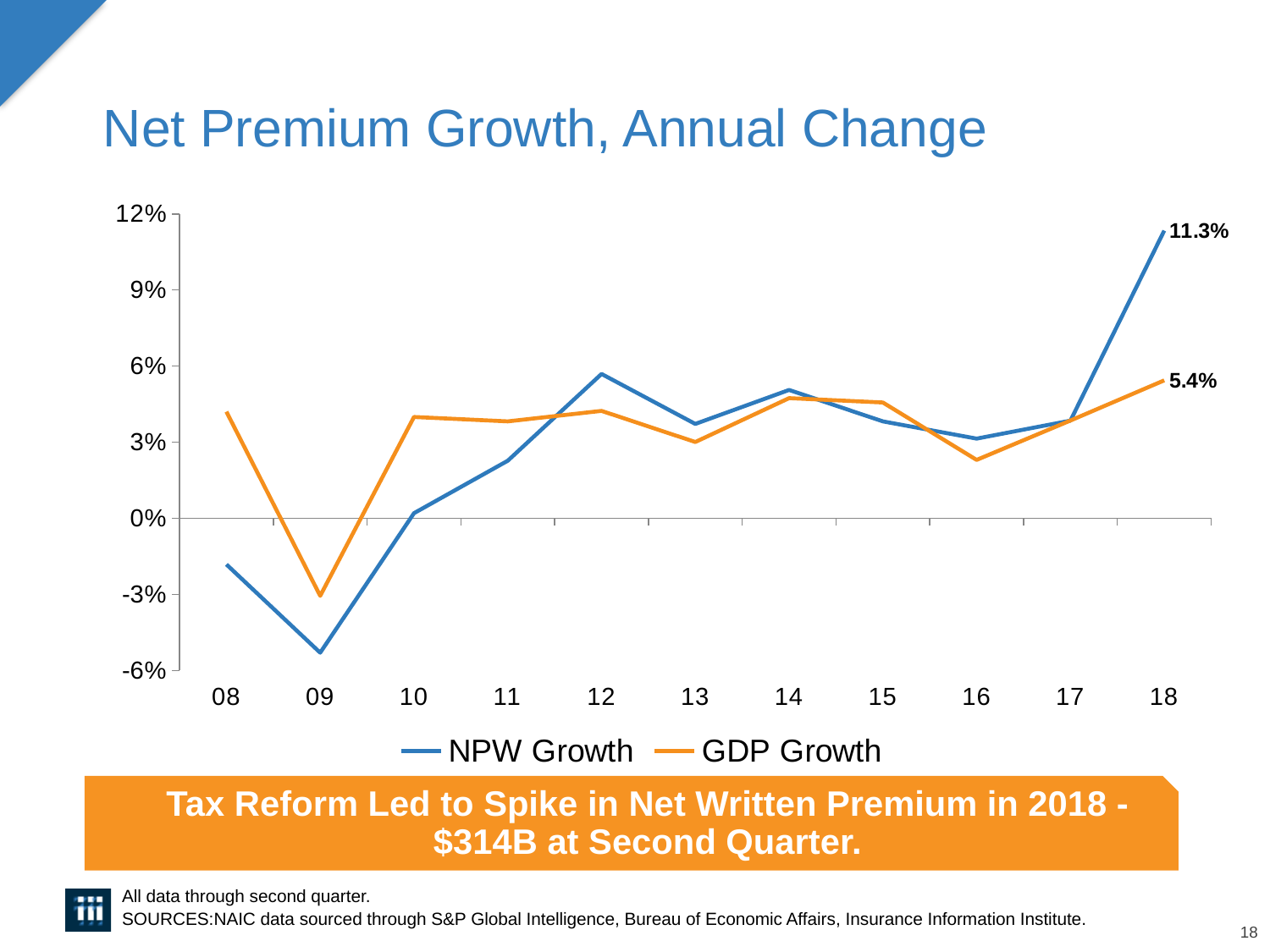
Does NPW Growth rise or fall from 17 to 18? Rise What is the GDP Growth value for 18? 5.4% How many years are shown on the x axis? 11 How many series does the legend list? 2 What is the NPW Growth value for 18? 11.3% Is the GDP Growth value for 10 greater or less than 3%? greater In which year is NPW Growth lowest? 09 In 18, which series is higher, NPW Growth or GDP Growth? NPW Growth Is the NPW Growth value for 09 greater or less than -3%? less What kind of chart is shown on the slide? Line chart In which year is NPW Growth highest? 18 What is the difference between NPW Growth and GDP Growth in 18? 5.9%